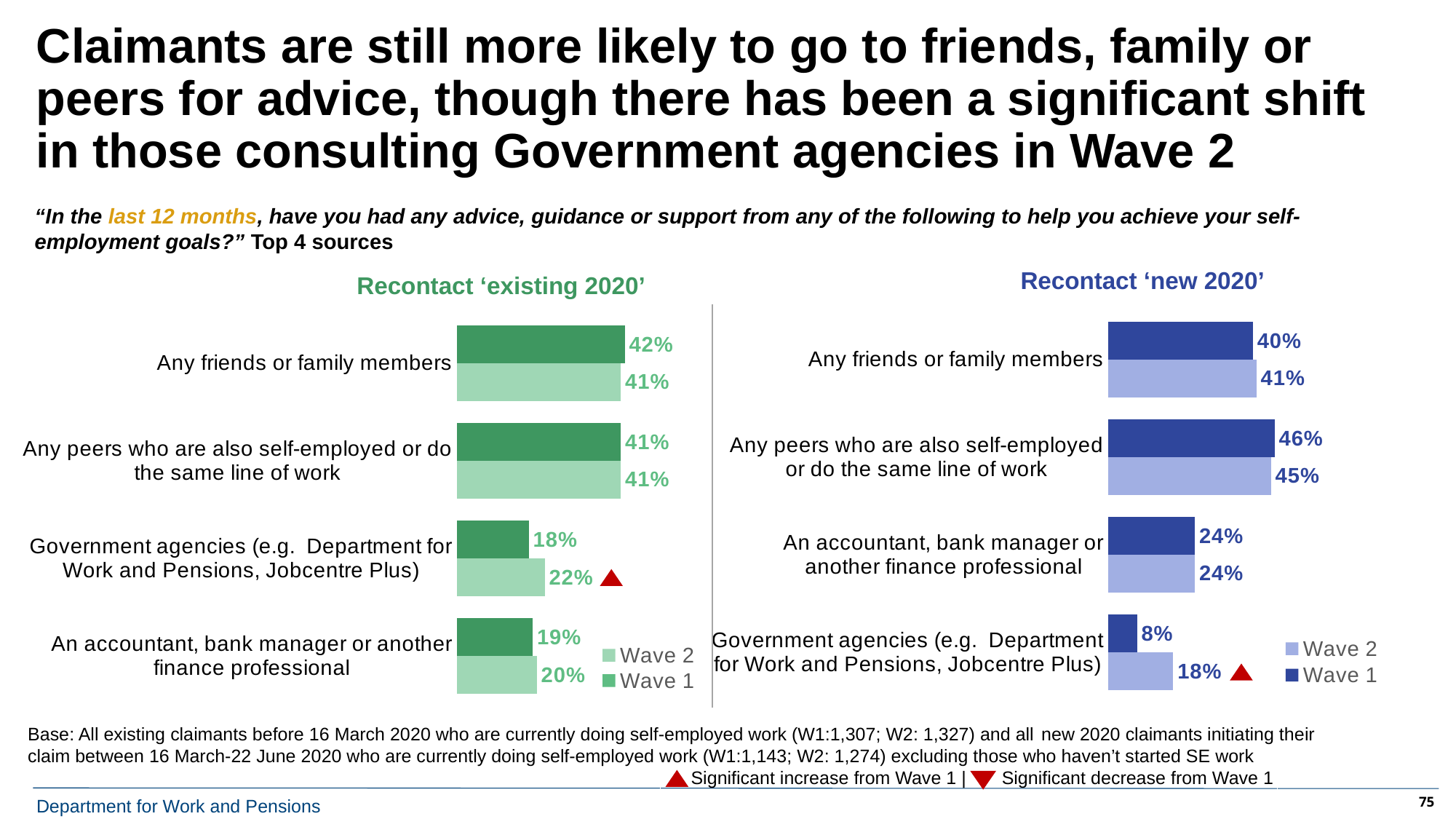
In the 'Recontact ‘new 2020’' chart, which category has the highest Wave 1 value? Any peers who are also self-employed or do the same line of work In the 'Recontact ‘new 2020’' chart, which category has the lowest Wave 2 value? Government agencies (e.g. Department for Work and Pensions, Jobcentre Plus) In the 'Recontact ‘existing 2020’' chart, what is the Wave 1 value for Any friends or family members? 42% How many categories are shown in the 'Recontact ‘existing 2020’' chart? 4 In the 'Recontact ‘existing 2020’' chart, what is the difference between the Wave 2 and Wave 1 values for Government agencies? 4 percentage points How many series does the legend of the 'Recontact ‘new 2020’' chart list? 2 In the 'Recontact ‘existing 2020’' chart, what is the Wave 2 value for Government agencies (e.g. Department for Work and Pensions, Jobcentre Plus)? 22% In the 'Recontact ‘new 2020’' chart, what is the Wave 1 value for Government agencies (e.g. Department for Work and Pensions, Jobcentre Plus)? 8% In the 'Recontact ‘new 2020’' chart, is the Wave 1 value for Any friends or family members larger or smaller than the Wave 1 value for Any peers who are also self-employed or do the same line of work? smaller In the 'Recontact ‘existing 2020’' chart, which category has the lowest Wave 1 value? Government agencies (e.g. Department for Work and Pensions, Jobcentre Plus) In the 'Recontact ‘new 2020’' chart, what is the difference between the Wave 2 and Wave 1 values for Government agencies? 10 percentage points In the 'Recontact ‘new 2020’' chart, what is the Wave 2 value for Any peers who are also self-employed or do the same line of work? 45%